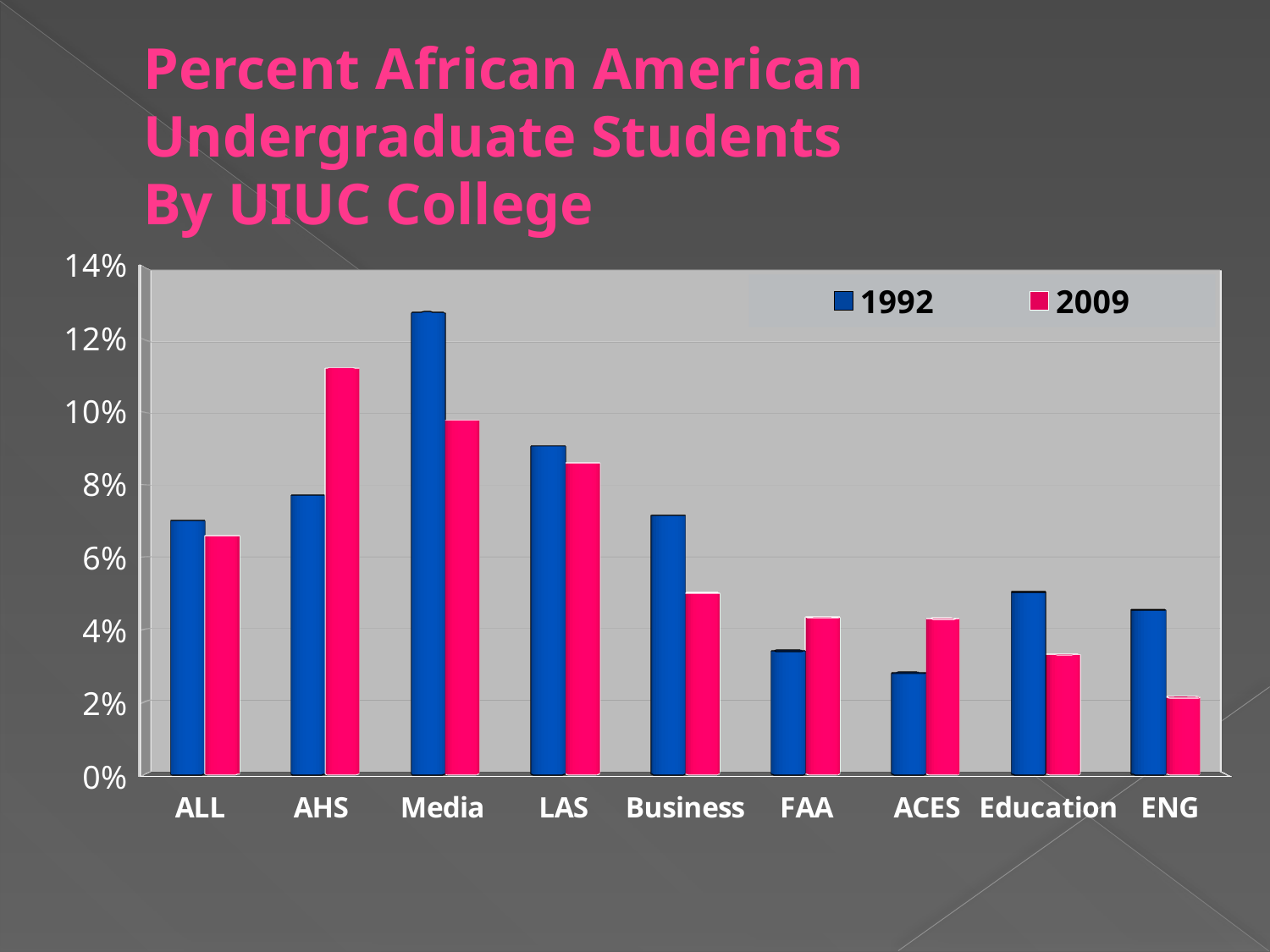
How many series does the legend list? 2 Is the 1992 value for Media greater or less than 12%? greater Which category has the highest 2009 value? AHS Is the 2009 value for AHS greater or less than 10%? greater Which category has the lowest 1992 value? ACES For Business, which year has the larger value, 1992 or 2009? 1992 For AHS, which year has the larger value, 1992 or 2009? 2009 How many colleges/categories are shown along the x axis? 9 Which category has the highest 1992 value? Media Is the 2009 value for ENG greater or less than 4%? less Which category has the lowest 2009 value? ENG What kind of chart is shown on the slide? Bar chart